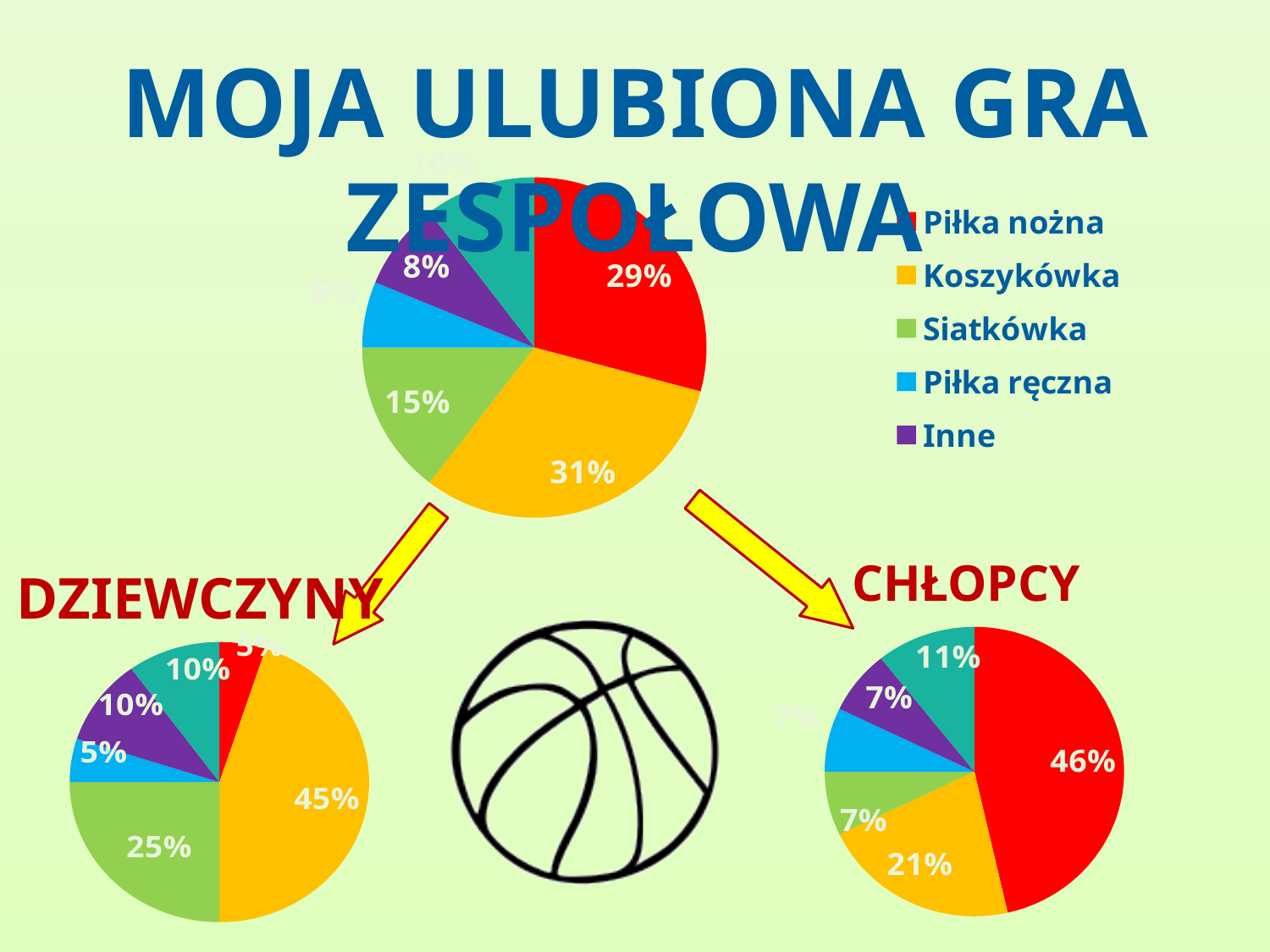
In the CHŁOPCY pie chart, which category has the largest slice? Piłka nożna In the DZIEWCZYNY pie chart, what share is shown for Siatkówka (the green slice)? 25% In the top pie chart, what share is shown for Siatkówka (the green slice)? 15% In the top pie chart, what share is shown for Inne (the purple slice)? 8% In the CHŁOPCY pie chart, what is the difference between the Piłka nożna share and the Koszykówka share? 25% In the DZIEWCZYNY pie chart, which category has the largest slice? Koszykówka In the DZIEWCZYNY pie chart, what share is shown for Koszykówka (the orange slice)? 45% In the CHŁOPCY pie chart, what share is shown for Koszykówka (the orange slice)? 21% What kind of chart is used on this slide? Pie chart In the CHŁOPCY pie chart, what share is shown for Piłka nożna (the red slice)? 46% In the top pie chart, what share is shown for Koszykówka (the orange slice)? 31% In the top pie chart, what share is shown for Piłka nożna (the red slice)? 29%